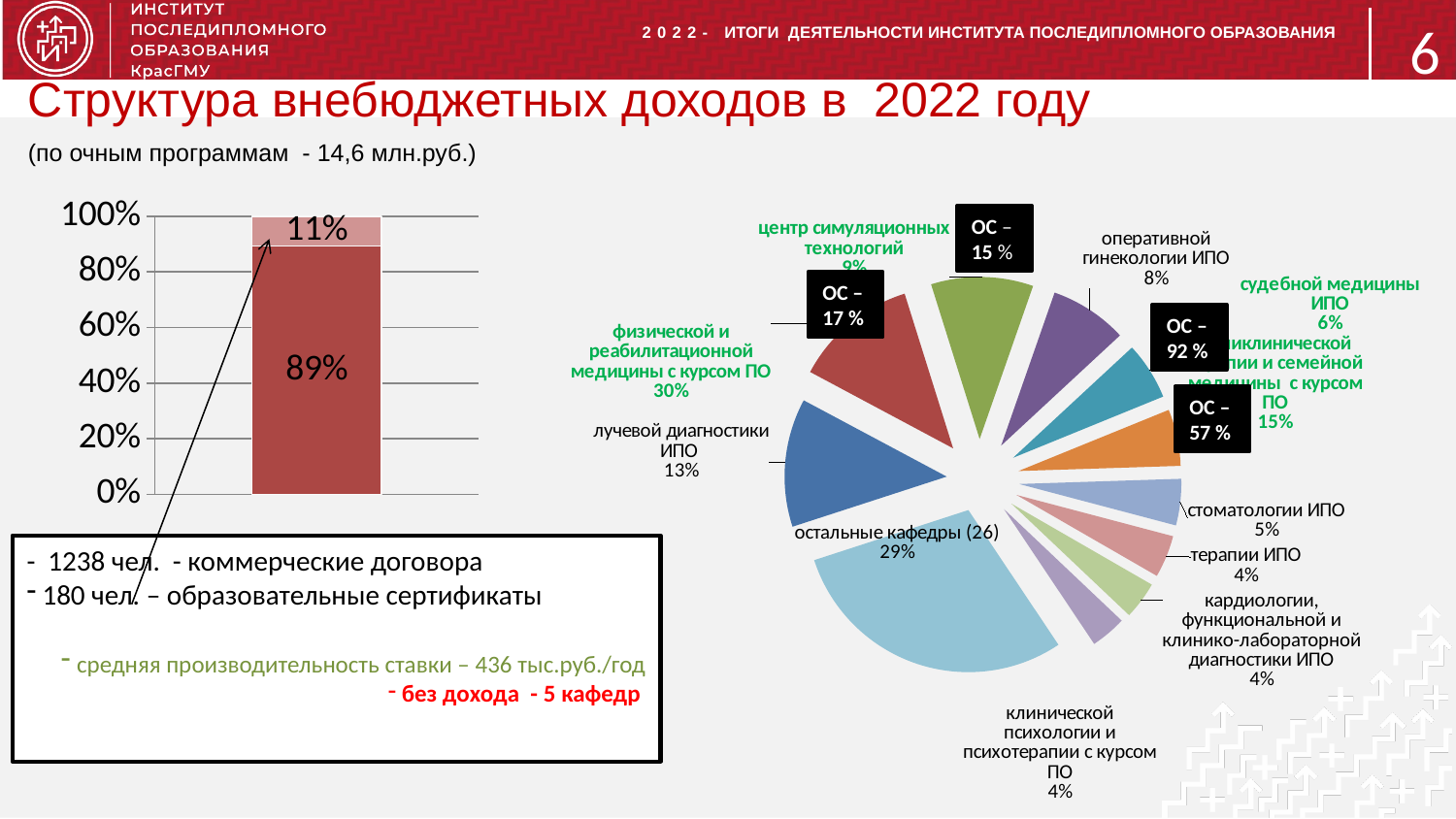
On the pie chart, what is the difference between the shares of 'лучевой диагностики ИПО' and 'судебной медицины ИПО'? 7% On the left bar chart, what is the value of the smaller (upper) segment of the stacked bar? 11% On the left bar chart, what is the value of the larger (lower) segment of the stacked bar? 89% On the pie chart, which has the larger share: 'стоматологии ИПО' or 'центр симуляционных технологий'? центр симуляционных технологий What kind of chart is shown on the right side of the slide? pie chart What kind of chart is shown on the left side of the slide? bar chart On the pie chart, what share is labelled for 'остальные кафедры (26)'? 29% On the pie chart, what share is labelled for 'лучевой диагностики ИПО'? 13% On the left bar chart, what is the total of the two segments of the stacked bar? 100% On the pie chart, what share is labelled for 'физической и реабилитационной медицины с курсом ПО'? 30% On the left bar chart, what is the difference between the two segments of the stacked bar? 78% On the pie chart, what share is labelled for 'оперативной гинекологии ИПО'? 8%